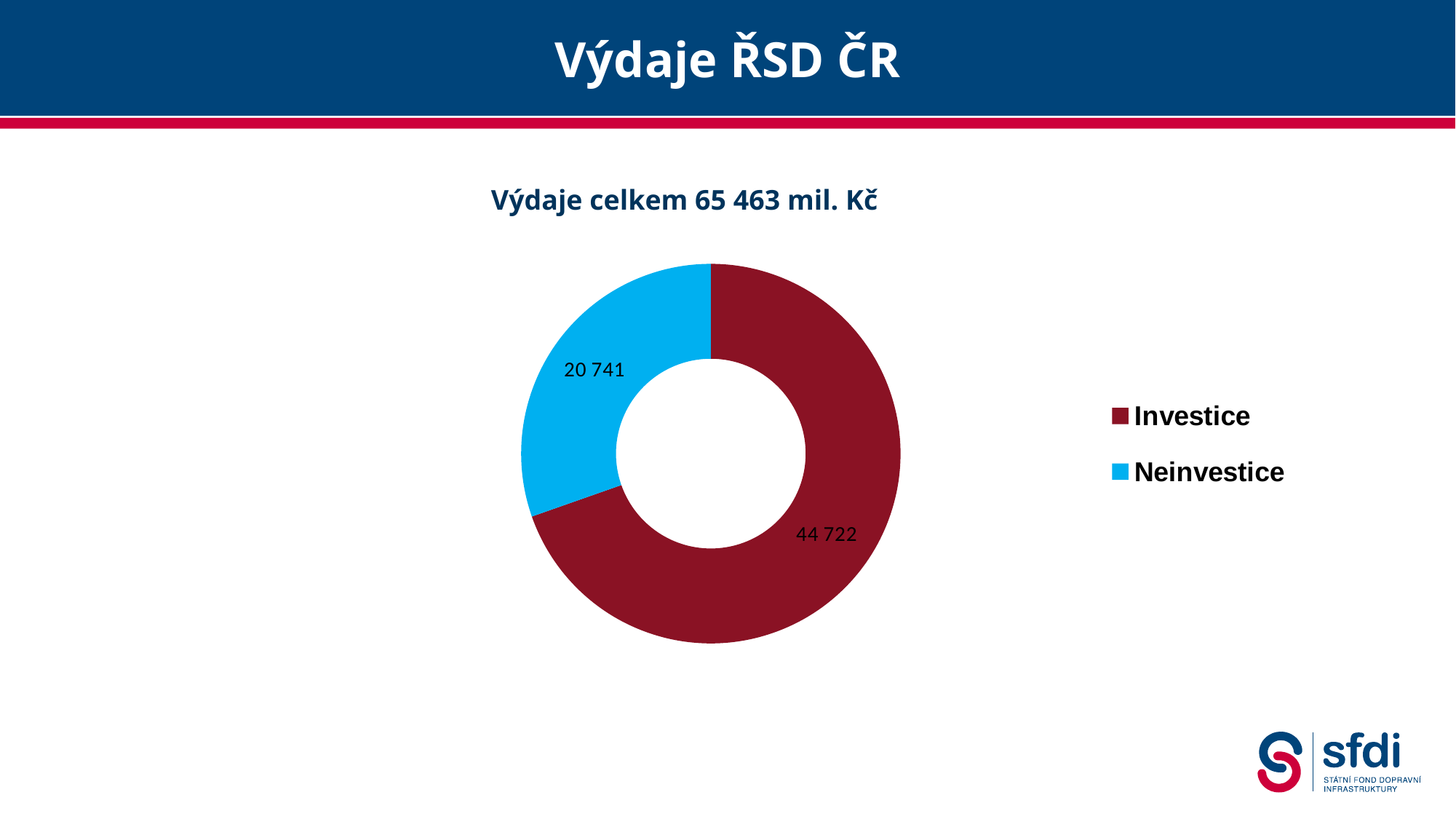
What kind of chart is shown on the slide? Doughnut (pie) chart What is the value for Investice? 44 722 Which category has the smallest slice? Neinvestice How many slices does the chart have? 2 Which category has the largest slice? Investice What is the difference between the values for Investice and Neinvestice? 23 981 What is the value for Neinvestice? 20 741 How many entries does the legend list? 2 What is the total of the two slices? 65 463 What is the title of the chart? Výdaje celkem 65 463 mil. Kč Which is larger, Investice or Neinvestice? Investice